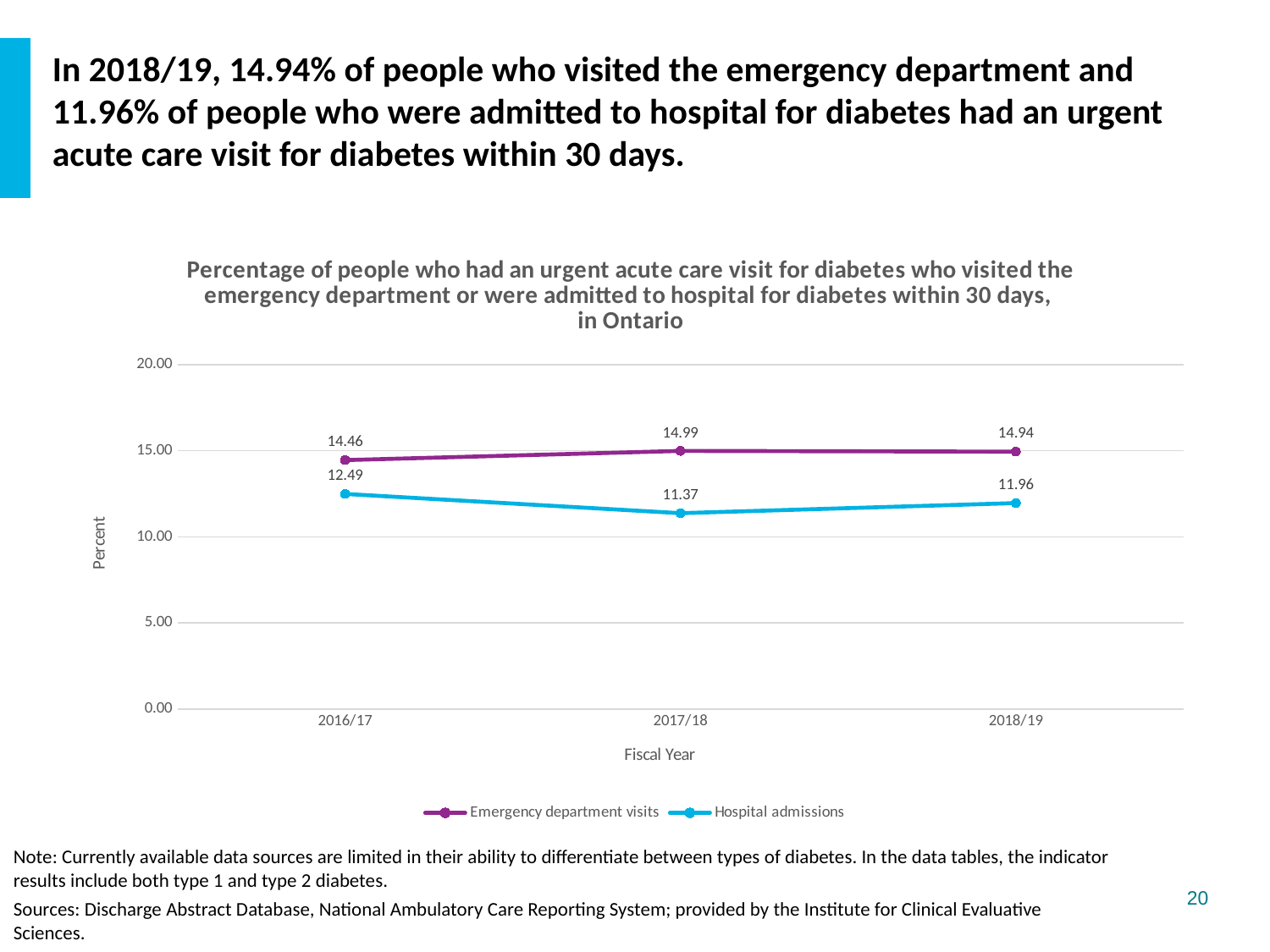
What is the value for Emergency department visits in 2017/18? 14.99 In which fiscal year is the Emergency department visits value lowest? 2016/17 Which series has the higher value in 2017/18, Emergency department visits or Hospital admissions? Emergency department visits What is the value for Hospital admissions in 2016/17? 12.49 Is the value for Hospital admissions in 2017/18 greater or less than 15.00? less In which fiscal year is the Hospital admissions value lowest? 2017/18 How many series does the legend list? 2 What is the difference between the Hospital admissions values in 2016/17 and 2017/18? 1.12 What is the difference between Emergency department visits and Hospital admissions in 2018/19? 2.98 What is the value for Hospital admissions in 2018/19? 11.96 What kind of chart is shown on the slide? line chart How many fiscal years are shown on the x axis? 3